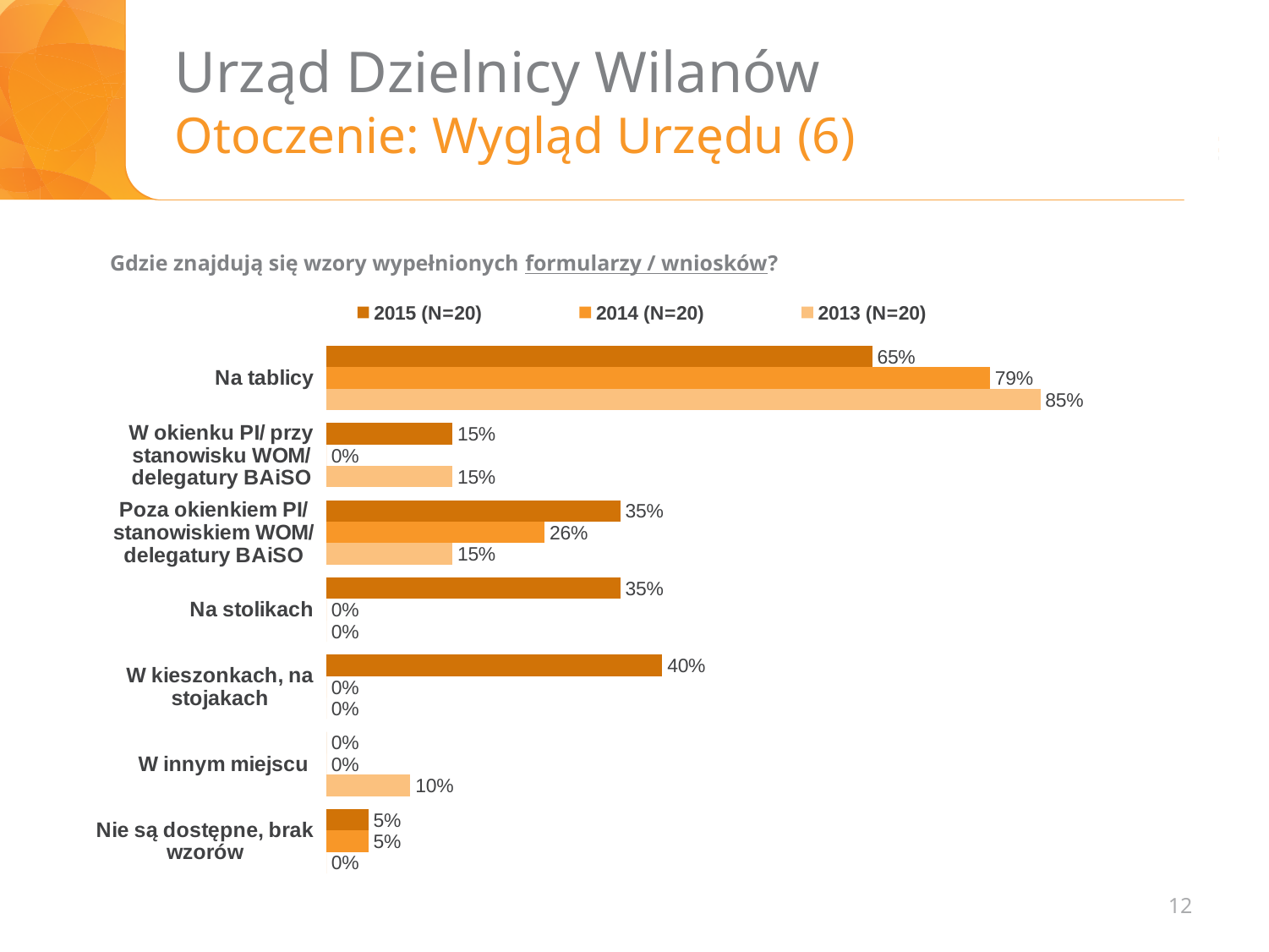
What is the value for "Na tablicy" in the 2013 (N=20) series? 85% Which is larger for "Poza okienkiem PI/ stanowiskiem WOM/ delegatury BAiSO": the 2015 (N=20) value or the 2014 (N=20) value? 2015 (N=20) Which category has the highest value in the 2013 (N=20) series? Na tablicy What is the value for "W innym miejscu" in the 2013 (N=20) series? 10% What is the value for "Na tablicy" in the 2015 (N=20) series? 65% What is the value for "W kieszonkach, na stojakach" in the 2015 (N=20) series? 40% How many series does the legend list? 3 What kind of chart is shown on the slide? Bar chart What is the value for "Nie są dostępne, brak wzorów" in the 2014 (N=20) series? 5% What is the difference between the 2013 (N=20) and 2015 (N=20) values for "Na tablicy"? 20% What is the value for "Poza okienkiem PI/ stanowiskiem WOM/ delegatury BAiSO" in the 2014 (N=20) series? 26% How many categories are shown on the chart? 7